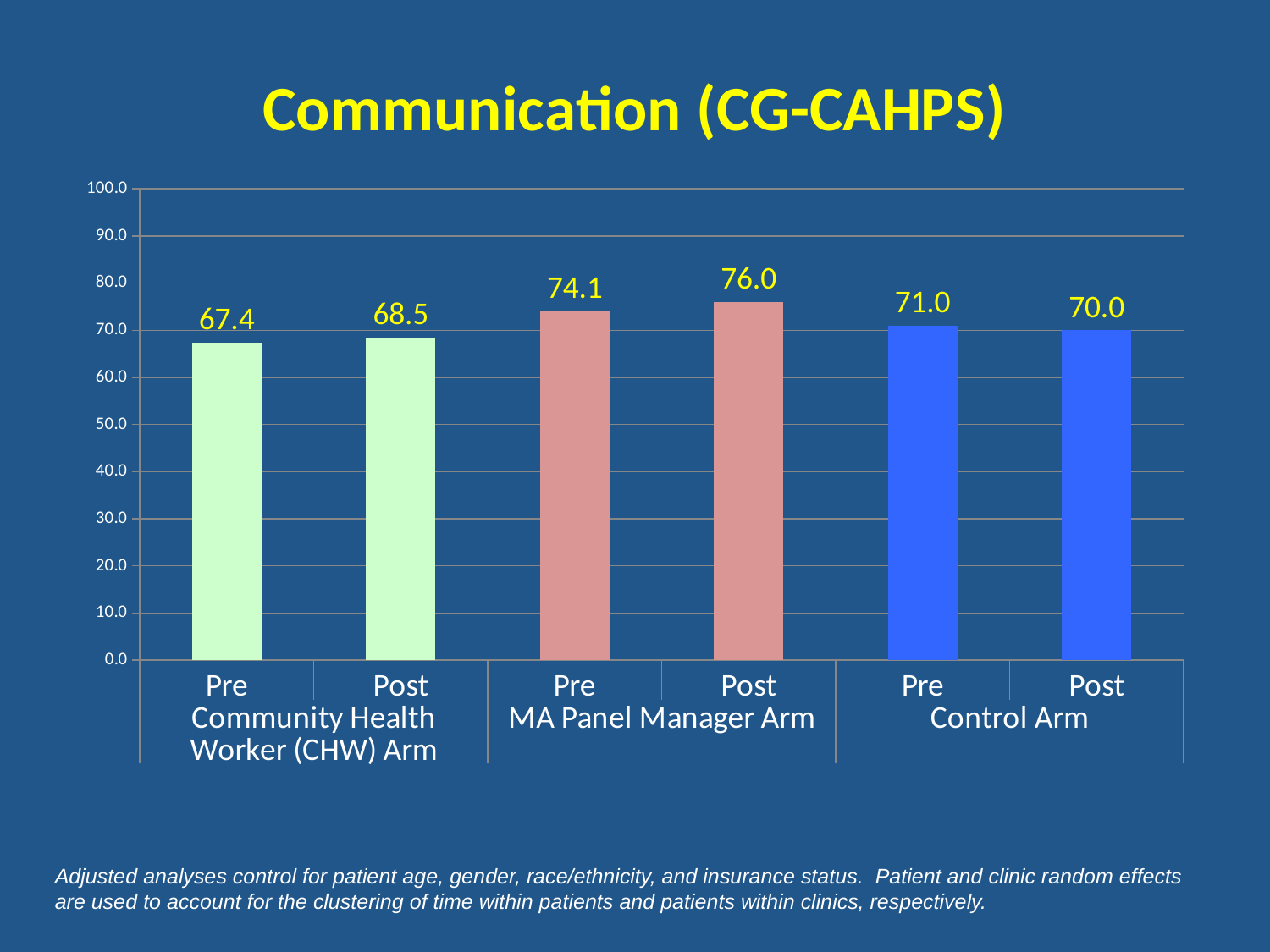
How many bars are plotted in the chart? 6 Is the Pre value for the MA Panel Manager Arm greater or less than 70.0? greater What is the Post value for the MA Panel Manager Arm? 76.0 What is the difference between the Pre and Post values for the Control Arm? 1.0 Which is larger, the Post value for the CHW Arm or the Post value for the Control Arm? Post value for the Control Arm What is the title of the chart? Communication (CG-CAHPS) Which bar has the lowest value? Pre, Community Health Worker (CHW) Arm What is the Pre value for the Control Arm? 71.0 What kind of chart is shown on the slide? Bar chart What is the difference between the Post and Pre values for the MA Panel Manager Arm? 1.9 What is the Pre value for the Community Health Worker (CHW) Arm? 67.4 Which bar has the highest value? Post, MA Panel Manager Arm